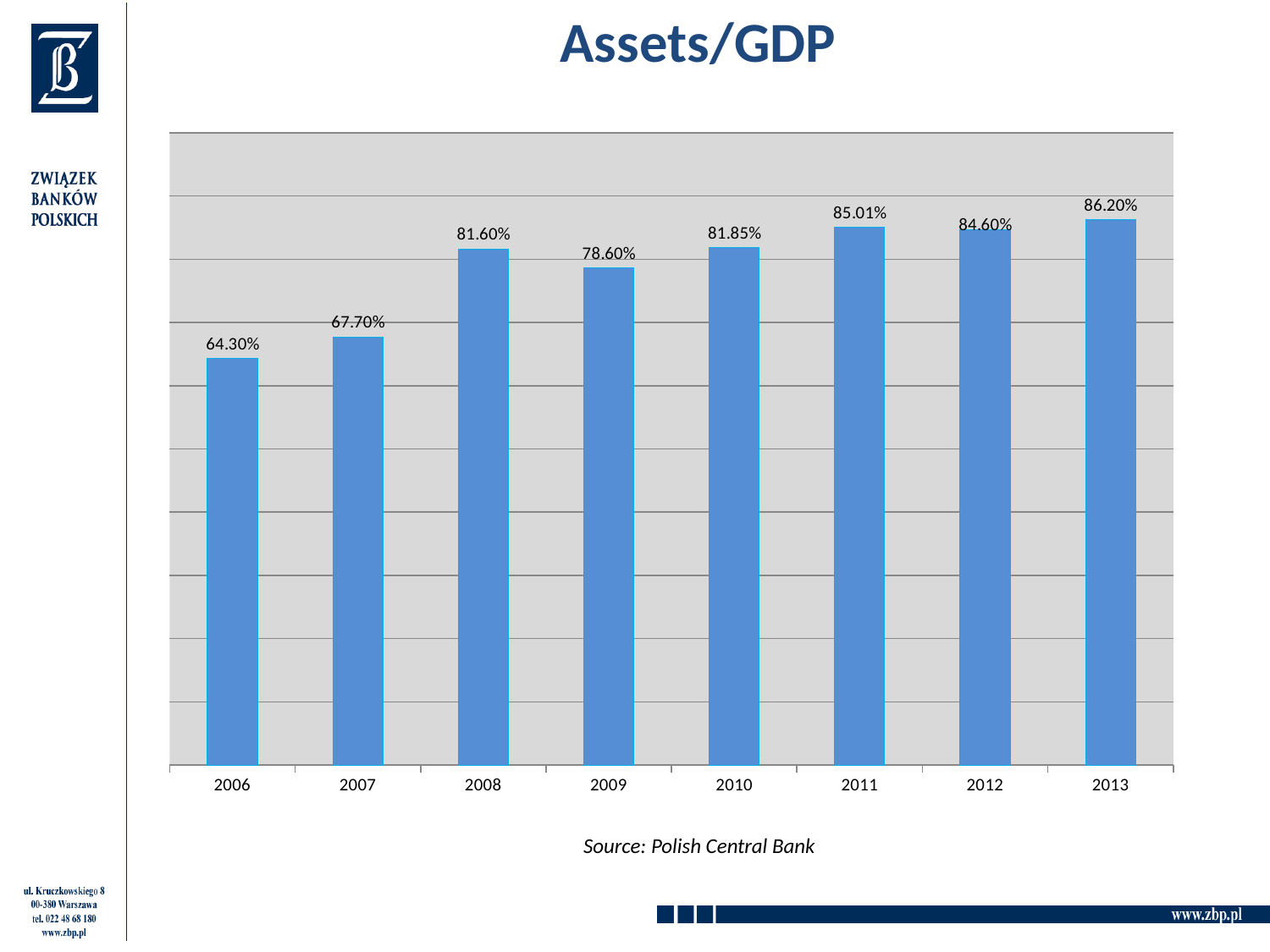
Overall, does the Assets/GDP value rise or fall from 2006 to 2013? Rise What kind of chart is shown on the slide? Bar chart What is the Assets/GDP value for 2009? 78.60% How many years are shown on the x axis of the chart? 8 Which year has the larger Assets/GDP value, 2008 or 2009? 2008 Which year has the highest Assets/GDP value? 2013 Which year has the lowest Assets/GDP value? 2006 What is the Assets/GDP value for 2006? 64.30% What is the difference between the Assets/GDP values for 2013 and 2006? 21.90 percentage points What is the Assets/GDP value for 2013? 86.20% What is the difference between the Assets/GDP values for 2010 and 2008? 0.25 percentage points Which year has the larger Assets/GDP value, 2011 or 2012? 2011